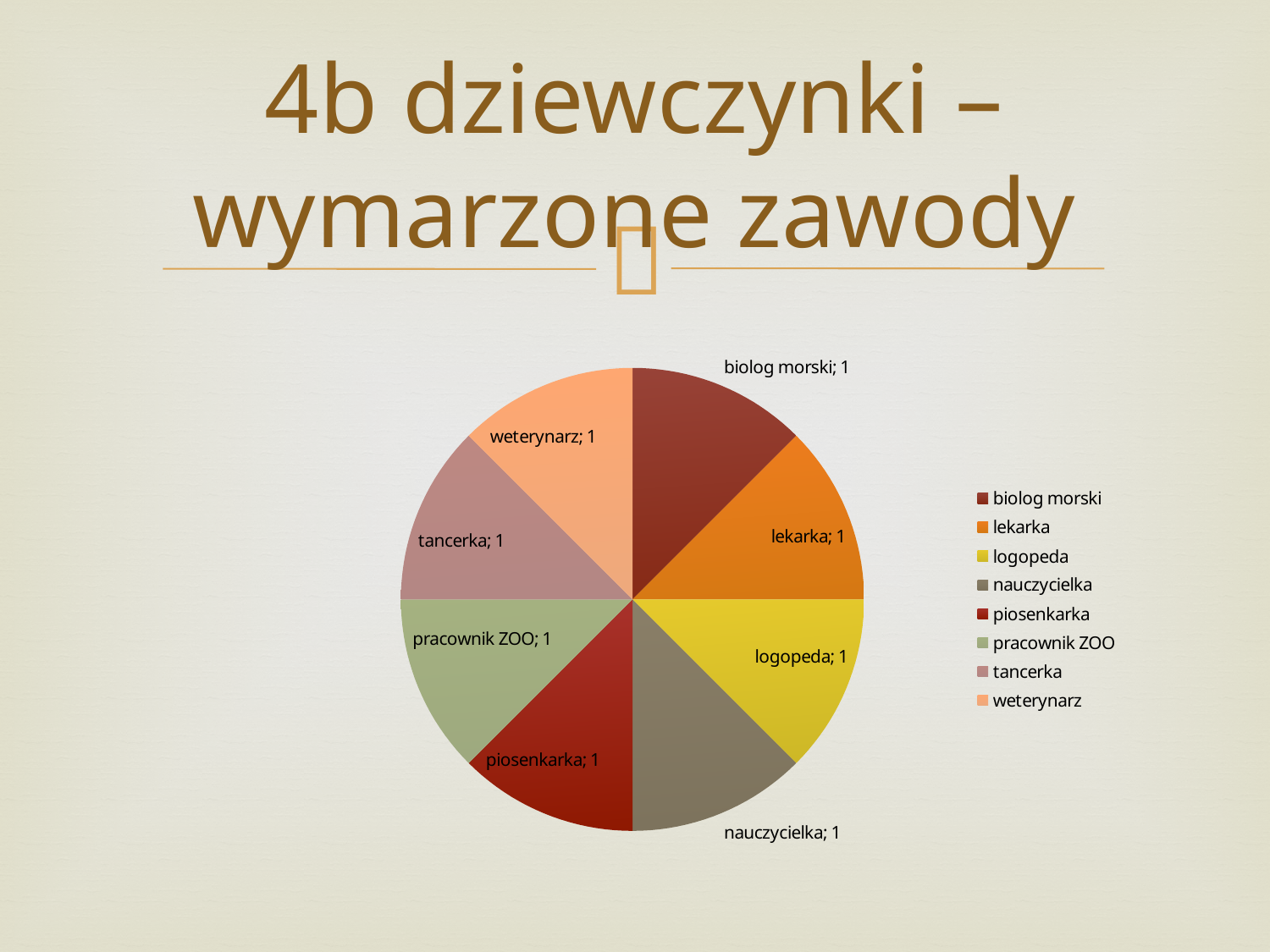
What is the value shown for the slice "biolog morski"? 1 How many entries does the legend of the pie chart list? 8 What share of the pie does the slice "logopeda" represent? 12.5% What is the total of all the values shown on the pie chart? 8 What is the title of the slide containing the pie chart? 4b dziewczynki – wymarzone zawody What is the value shown for the slice "lekarka"? 1 How many slices does the pie chart have? 8 Is the value for "piosenkarka" larger than, smaller than, or equal to the value for "lekarka"? equal What is the value shown for the slice "pracownik ZOO"? 1 What is the difference between the values for "tancerka" and "nauczycielka"? 0 What is the value shown for the slice "weterynarz"? 1 What kind of chart is shown on the slide? pie chart